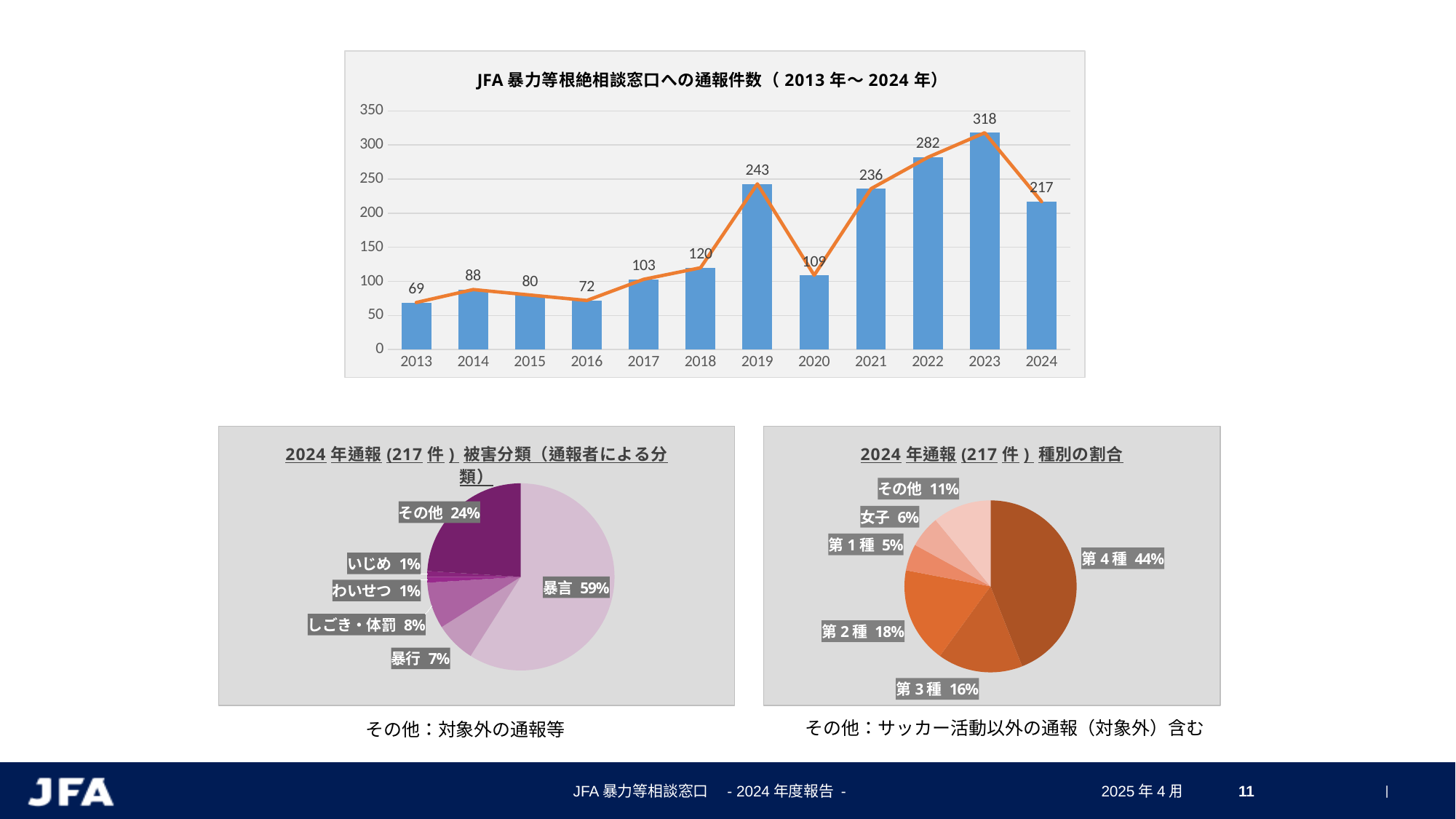
In the top chart (JFA暴力等根絶相談窓口への通報件数), what is the value for 2019? 243 In the bottom-left pie chart (2024年通報 被害分類), how many categories are shown? 6 In the top chart (JFA暴力等根絶相談窓口への通報件数), what is the difference between the values for 2023 and 2024? 101 In the top chart (JFA暴力等根絶相談窓口への通報件数), how many years are shown on the x axis? 12 In the bottom-right pie chart (2024年通報 種別の割合), what share does 第2種 have? 18% In the top chart (JFA暴力等根絶相談窓口への通報件数), which year has the highest value? 2023 In the bottom-left pie chart (2024年通報 被害分類), which category has the largest share? 暴言 In the top chart (JFA暴力等根絶相談窓口への通報件数), do the values rise or fall from 2020 to 2023? rise In the bottom-right pie chart (2024年通報 種別の割合), what is the difference between the shares of 第4種 and 第3種? 28% In the top chart (JFA暴力等根絶相談窓口への通報件数), which year has the lowest value? 2013 In the bottom-left pie chart (2024年通報 被害分類), what share does 暴言 have? 59% In the top chart (JFA暴力等根絶相談窓口への通報件数), which is larger, the value for 2020 or the value for 2021? 2021